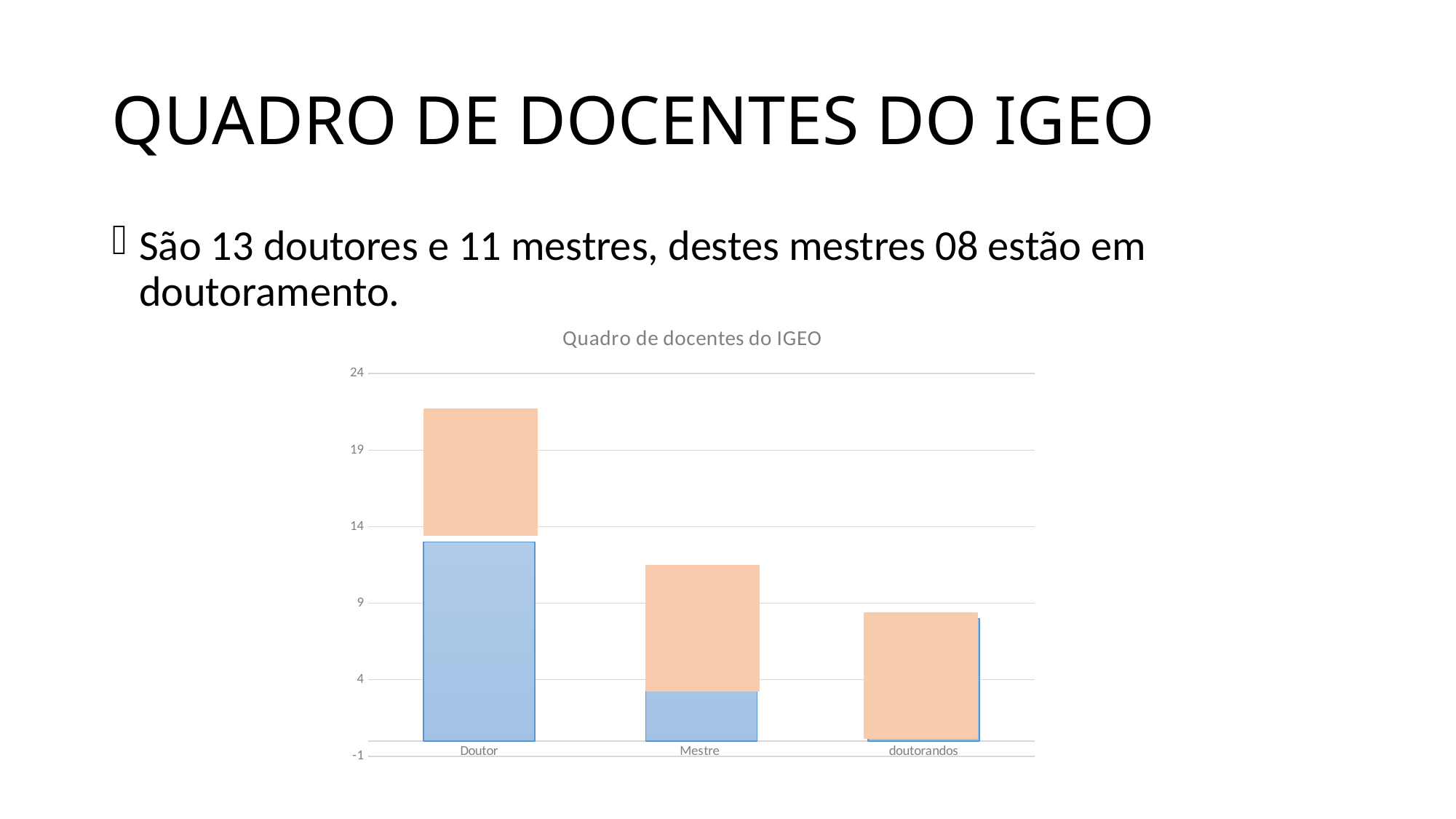
Which category has the shortest stacked bar in the chart? doutorandos Is the total height of the doutorandos bar greater or less than 14? less Which stacked bar is taller, Mestre or doutorandos? Mestre What kind of chart is shown on the slide? Bar chart Do the total bar heights rise or fall from left to right across the x axis? fall Is the total height of the Mestre bar greater or less than 9? greater Which category has the tallest stacked bar in the chart? Doutor Is the blue segment of the Mestre bar greater or less than 4? less How many categories are shown on the x axis of the chart? 3 What is the title of the chart? Quadro de docentes do IGEO